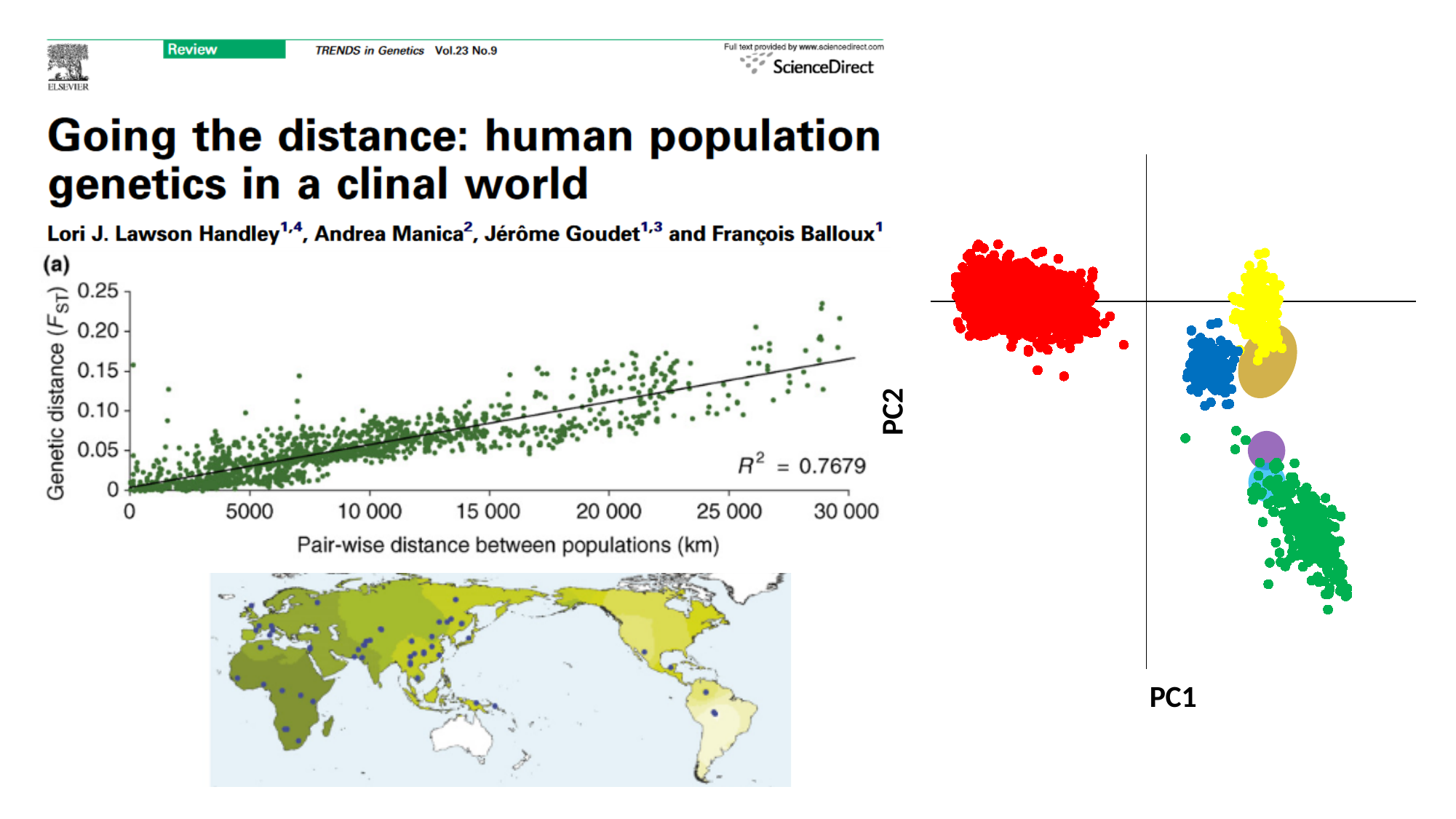
How many tick values are labelled on the y axis of the left-hand chart? 6 What is the label of the horizontal axis on the right-hand chart? PC1 What kind of chart is the left-hand chart showing genetic distance against pair-wise distance? scatter plot On the left-hand chart, what is the highest tick value shown on the y axis? 0.25 On the left-hand chart, what is the highest tick value shown on the x axis? 30 000 What kind of chart is the right-hand chart with PC1 and PC2 axes? scatter plot What is the label of the x axis on the left-hand chart? Pair-wise distance between populations (km) On the left-hand chart, does genetic distance rise or fall as pair-wise distance between populations increases? rise On the right-hand chart, which coloured cluster extends to the lowest PC2 values? green On the right-hand chart, which coloured cluster has the lowest PC1 values (lies left of the vertical axis)? red On the left-hand chart, what R² value is printed for the fitted line? 0.7679